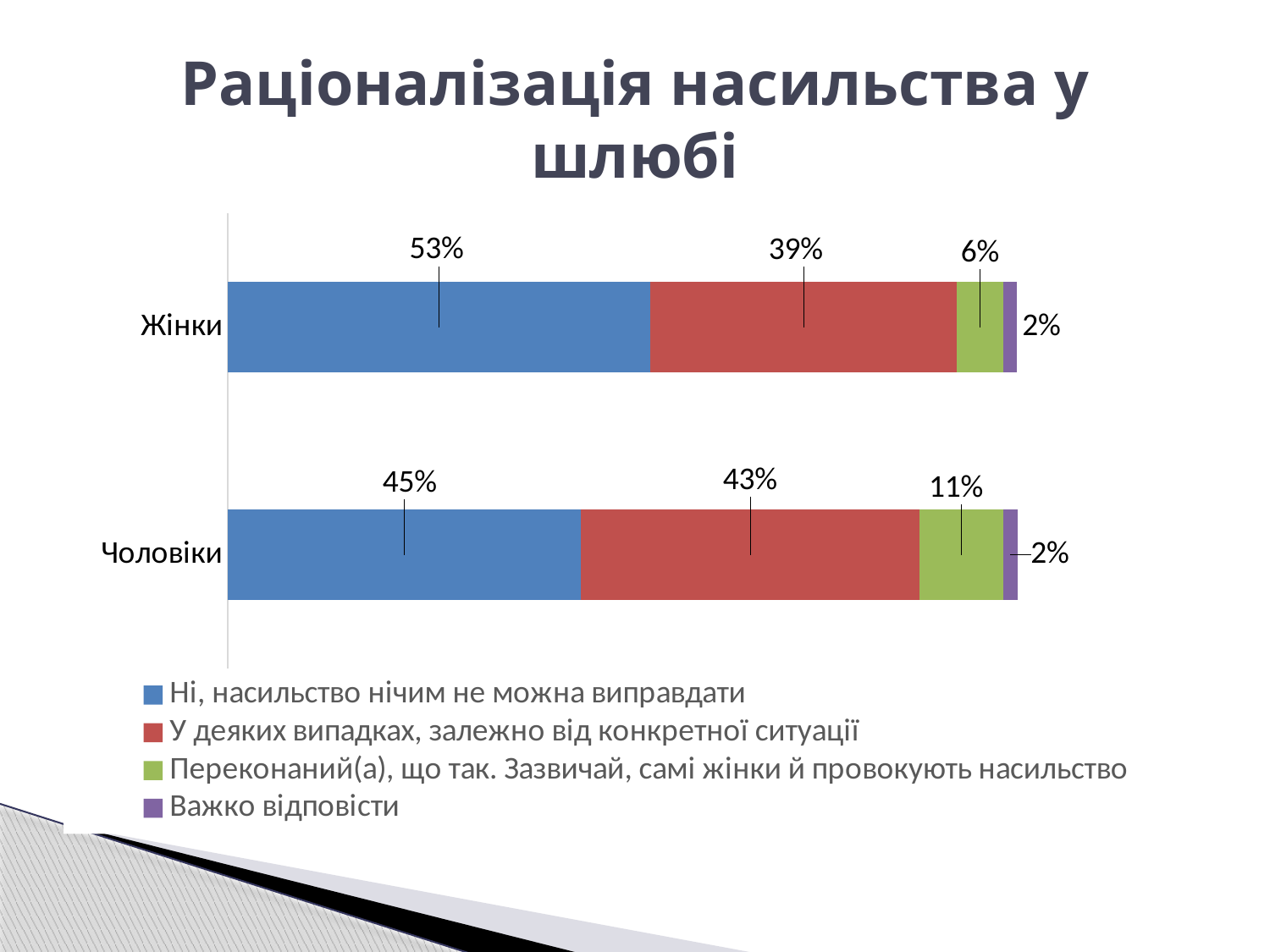
What is the value for Чоловіки in the series "Переконаний(а), що так. Зазвичай, самі жінки й провокують насильство"? 11% How many categories are shown on the chart? 2 What is the value for Жінки in the series "Ні, насильство нічим не можна виправдати"? 53% Which category has the higher value in the series "Ні, насильство нічим не можна виправдати", Жінки or Чоловіки? Жінки What is the difference between the values for Чоловіки and Жінки in the series "Переконаний(а), що так. Зазвичай, самі жінки й провокують насильство"? 5% What is the value for Жінки in the series "Важко відповісти"? 2% How many series does the legend list? 4 What is the title of the chart? Раціоналізація насильства у шлюбі What is the total of the stacked bar for Жінки? 100% What kind of chart is shown on the slide? Stacked bar chart What is the value for Чоловіки in the series "У деяких випадках, залежно від конкретної ситуації"? 43% What is the difference between the values for Жінки and Чоловіки in the series "Ні, насильство нічим не можна виправдати"? 8%